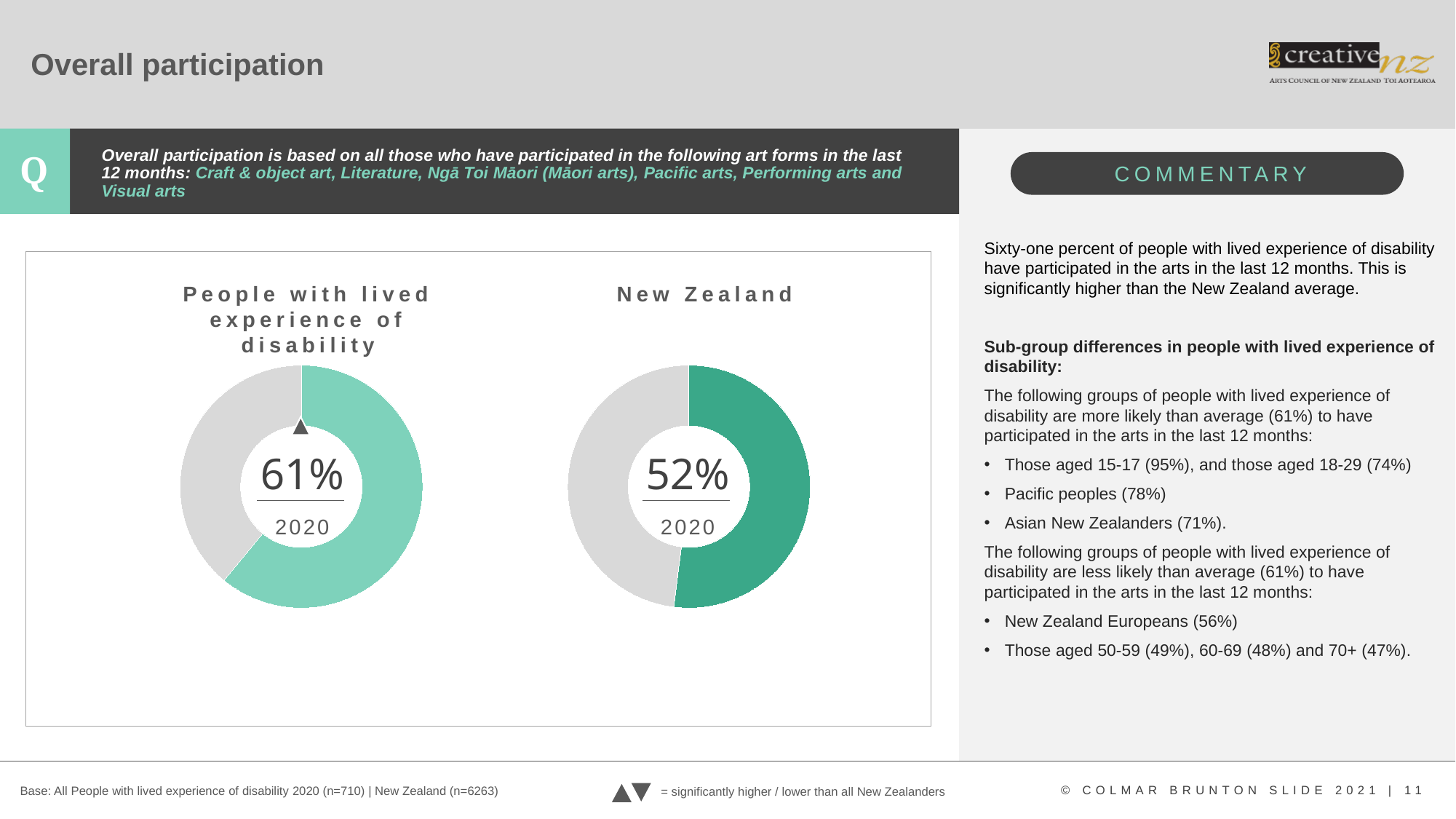
In the 'New Zealand' chart, what share of the donut is grey? 48% What year is labelled beneath the percentage in the 'New Zealand' chart? 2020 What year is labelled beneath the percentage in the 'People with lived experience of disability' chart? 2020 What is the title of the chart on the right? New Zealand What kind of chart is used to show the participation rates on this slide? Donut (pie) chart In the 'New Zealand' chart, what percentage is shown in the centre? 52% What does the upward triangle symbol above the 61% in the 'People with lived experience of disability' chart indicate? Significantly higher than all New Zealanders In the 'People with lived experience of disability' chart, what share of the donut is coloured (non-grey)? 61% In the 'People with lived experience of disability' chart, what percentage is shown in the centre? 61% Which chart shows the higher participation rate, 'People with lived experience of disability' or 'New Zealand'? People with lived experience of disability What is the difference between the participation rate for people with lived experience of disability and the New Zealand rate? 9 percentage points How many donut charts are shown on the slide? 2